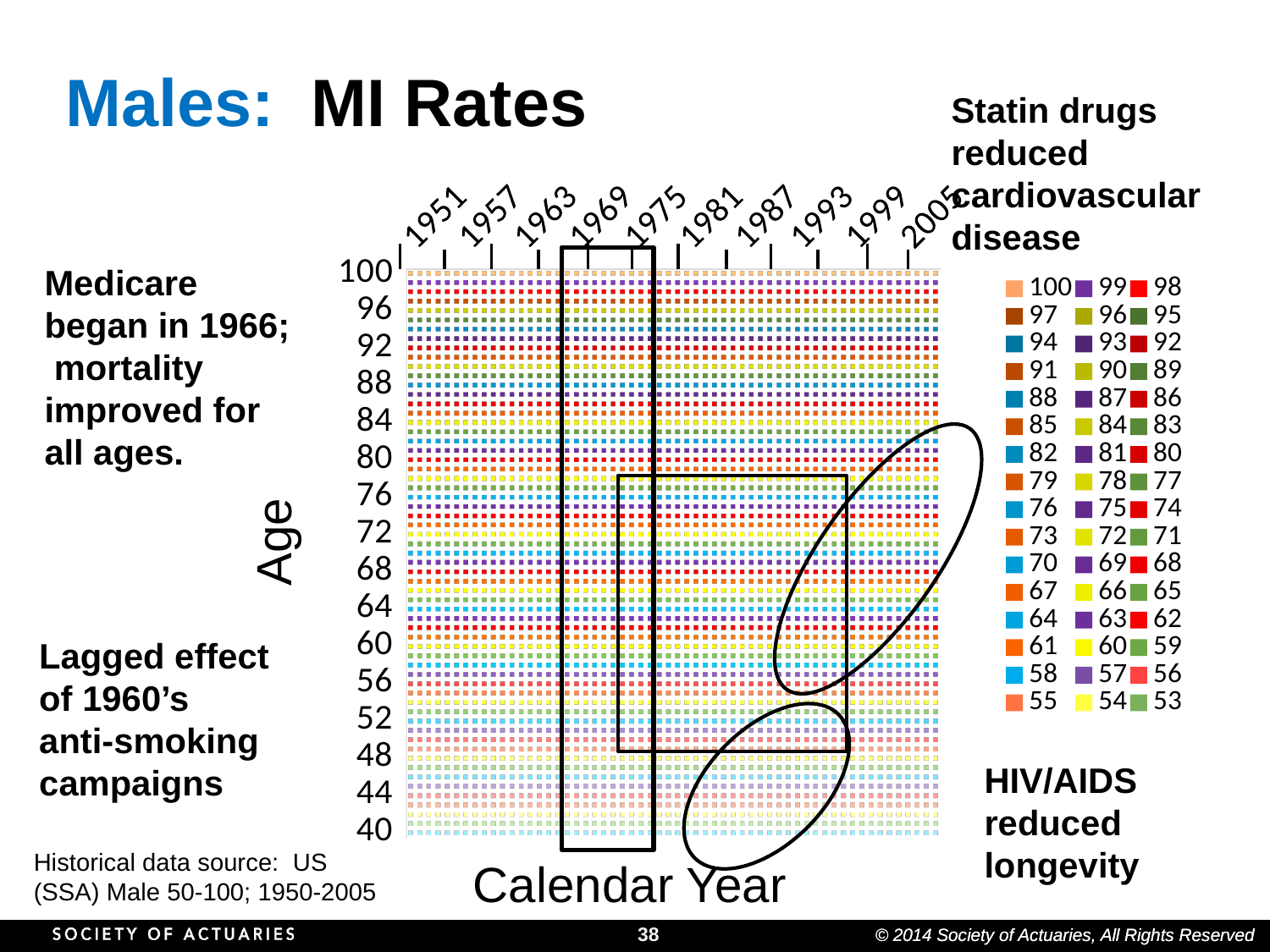
What kind of chart is shown on the slide? scatter chart What is the title of the chart on the slide? Males: MI Rates What is the highest value shown on the chart's Age axis? 100 How many year labels are shown along the chart's x axis? 10 What is the label of the chart's x axis? Calendar Year What is the lowest age series listed in the chart's legend? 53 What is the last year label on the chart's x axis? 2005 What is the first year label on the chart's x axis? 1951 What is the lowest value shown on the chart's Age axis? 40 What is the highest age series listed in the chart's legend? 100 How many series does the chart's legend list? 48